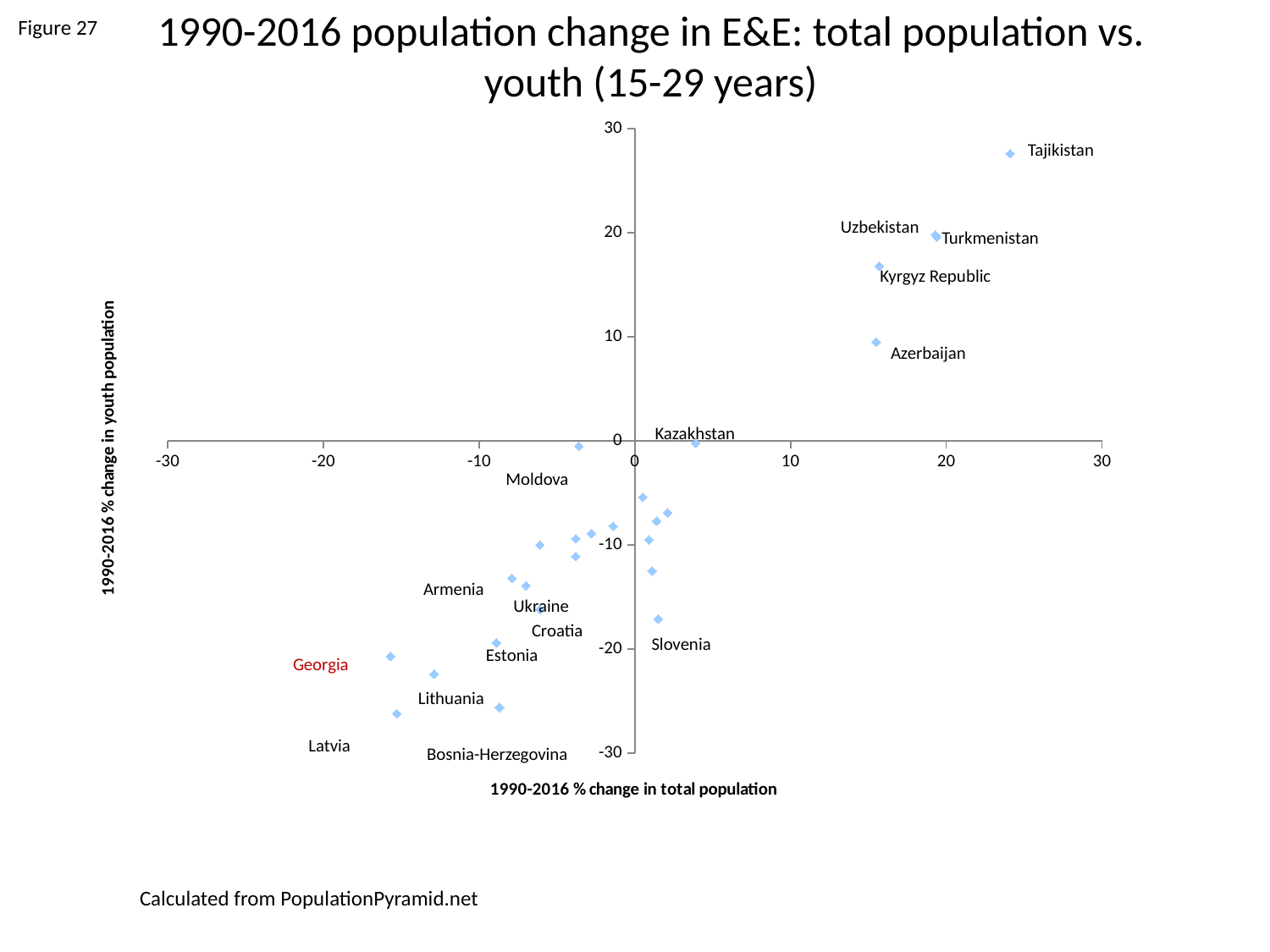
Is the 1990-2016 % change in youth population for Latvia greater or less than -20? less Is the 1990-2016 % change in total population for Georgia greater or less than -10? less Which country label on the chart is shown in red? Georgia Is the 1990-2016 % change in total population for Azerbaijan greater or less than 10? greater Which has the larger 1990-2016 % change in youth population, Kyrgyz Republic or Azerbaijan? Kyrgyz Republic Which labelled country has the highest 1990-2016 % change in youth population? Tajikistan Which labelled country has the lowest 1990-2016 % change in youth population? Latvia What is the title of the horizontal axis? 1990-2016 % change in total population What kind of chart is shown on the slide? scatter chart